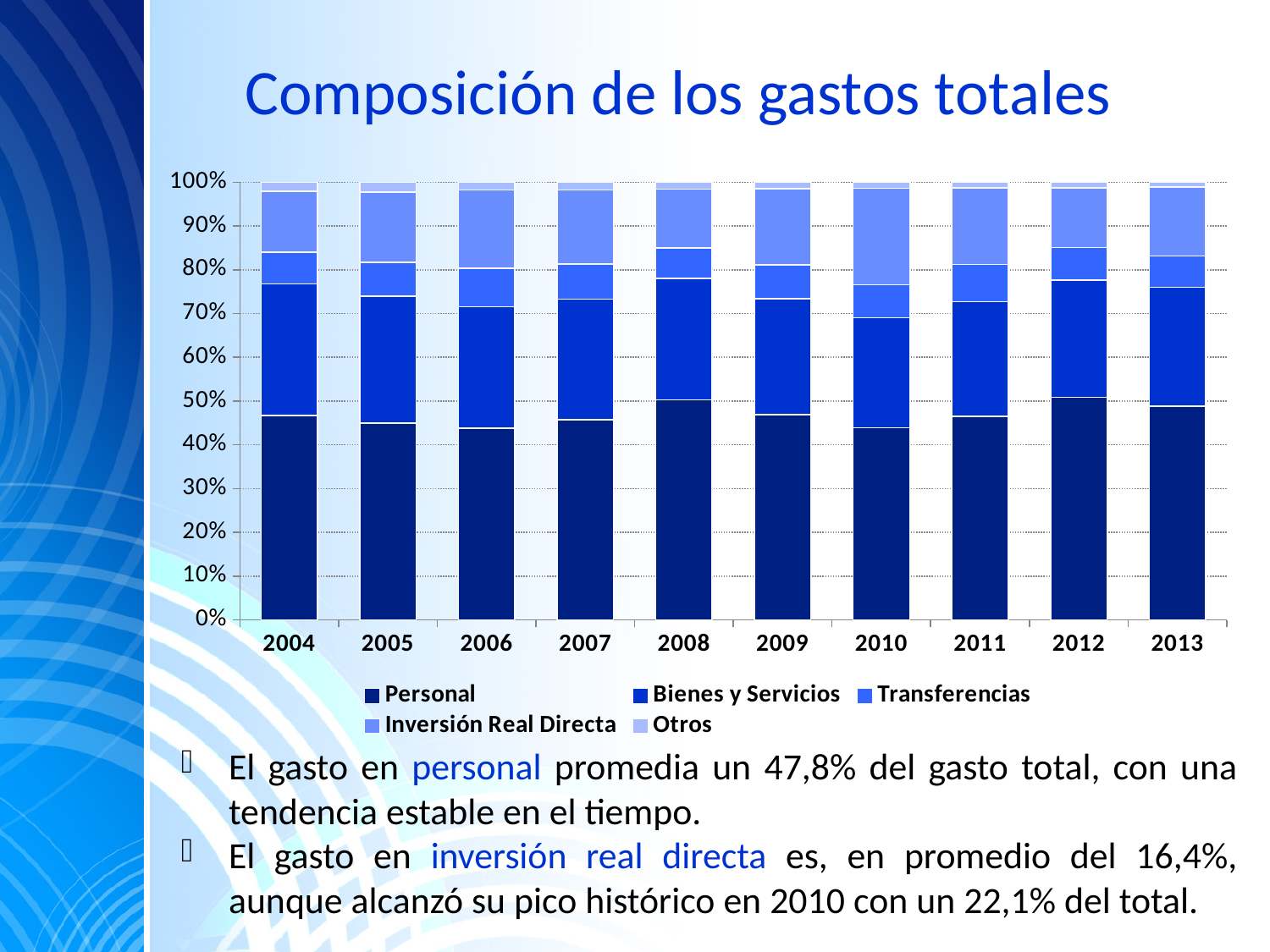
How many series does the chart legend list? 5 Which year has the larger Personal share, 2008 or 2006? 2008 What is the first year shown on the x axis of the chart? 2004 What kind of chart is shown on the slide? Stacked bar chart In which year is the Inversión Real Directa segment the largest? 2010 Is the Personal share in 2010 greater or less than 50%? less How many years are shown on the x axis of the chart? 10 What is the title of the slide containing the chart? Composición de los gastos totales Is the Personal share in 2004 greater or less than 40%? greater Which year has the larger Inversión Real Directa share, 2010 or 2004? 2010 Which series is shown at the bottom of each stacked bar? Personal Is the Personal share in 2006 greater or less than 50%? less